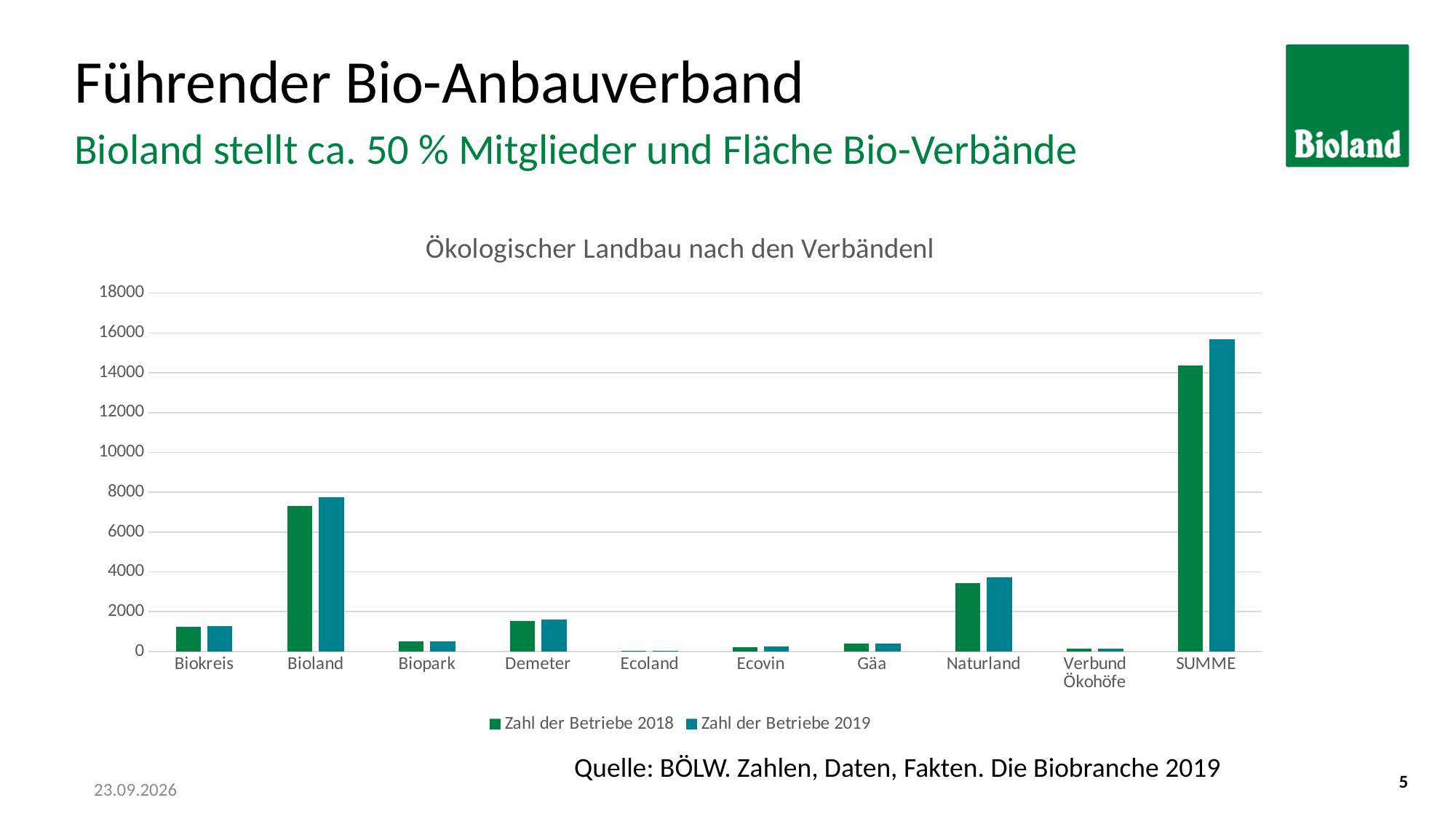
Is the value for Bioland in Zahl der Betriebe 2019 greater or less than 8000? less Which category has the highest value for Zahl der Betriebe 2019? SUMME Is the value for Naturland in Zahl der Betriebe 2019 greater or less than 4000? less Excluding SUMME, which association has the highest value for Zahl der Betriebe 2018? Bioland What is the title of the chart? Ökologischer Landbau nach den Verbändenl How many series does the chart legend list? 2 How many categories are shown on the x axis of the chart? 10 Which category has the lowest value for Zahl der Betriebe 2019? Ecoland Is the value for SUMME in Zahl der Betriebe 2019 greater or less than 16000? less For Bioland, which is larger: Zahl der Betriebe 2018 or Zahl der Betriebe 2019? Zahl der Betriebe 2019 What type of chart is shown on the slide? bar chart